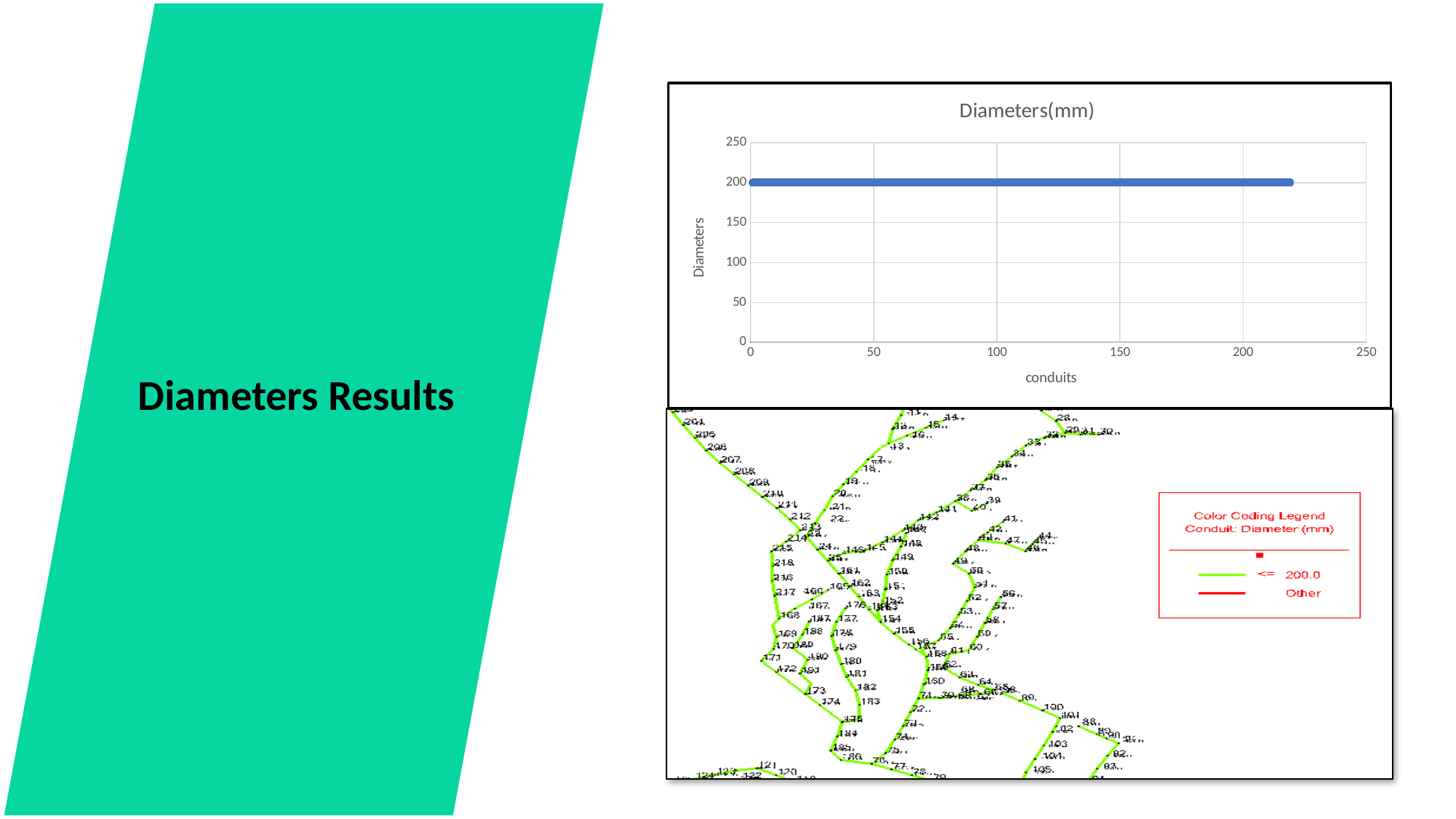
What kind of chart is the "Diameters(mm)" chart? scatter chart In the "Diameters(mm)" chart, what diameter value do the plotted points lie on? 200 In the "Diameters(mm)" chart, do the diameter values rise, fall, or stay constant as the conduit number increases? stay constant In the "Diameters(mm)" chart, is the diameter of the conduit at x = 200 greater or less than 50? greater In the "Diameters(mm)" chart, what is the highest value shown on the y axis? 250 In the "Diameters(mm)" chart, is the diameter of the conduit at x = 100 greater or less than 100? greater What is the title of the chart on the slide? Diameters(mm) In the "Diameters(mm)" chart, is the diameter value for the plotted conduits greater or less than 150? greater What is the label of the x axis in the "Diameters(mm)" chart? conduits